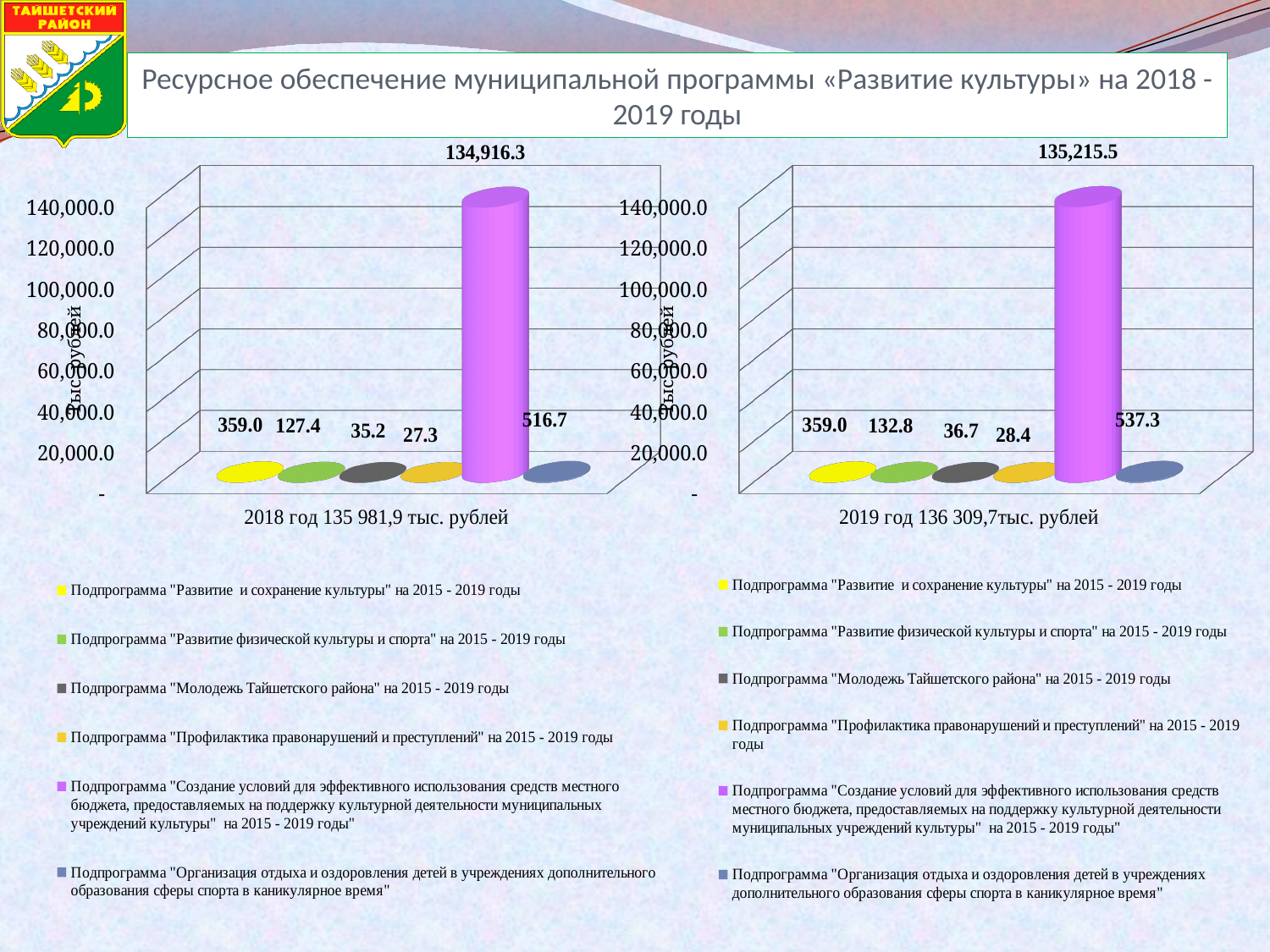
On the 2018 chart (left), what is the value for the subprogram "Развитие физической культуры и спорта"? 127.4 On the 2019 chart (right), what is the value for the subprogram "Организация отдыха и оздоровления детей..."? 537.3 On the 2019 chart (right), which subprogram has the highest value? Подпрограмма "Создание условий для эффективного использования средств местного бюджета, предоставляемых на поддержку культурной деятельности муниципальных учреждений культуры" на 2015 - 2019 годы What is the title shown below the left chart? 2018 год 135 981,9 тыс. рублей On the 2018 chart (left), which subprogram has the lowest value? Подпрограмма "Профилактика правонарушений и преступлений" на 2015 - 2019 годы What kind of chart is the 2019 chart (right)? Bar chart How many series does the legend of the 2018 chart (left) list? 6 Which is larger: the value for "Организация отдыха и оздоровления детей..." on the 2018 chart or on the 2019 chart? 2019 chart (537.3) On the 2019 chart (right), what is the value for the subprogram "Молодежь Тайшетского района"? 36.7 On the 2019 chart (right), what is the value for the subprogram "Создание условий для эффективного использования средств местного бюджета..."? 135,215.5 On the 2018 chart (left), what is the difference between the values for "Развитие и сохранение культуры" (359.0) and "Развитие физической культуры и спорта" (127.4)? 231.6 On the 2018 chart (left), what is the value for the subprogram "Создание условий для эффективного использования средств местного бюджета..."? 134,916.3